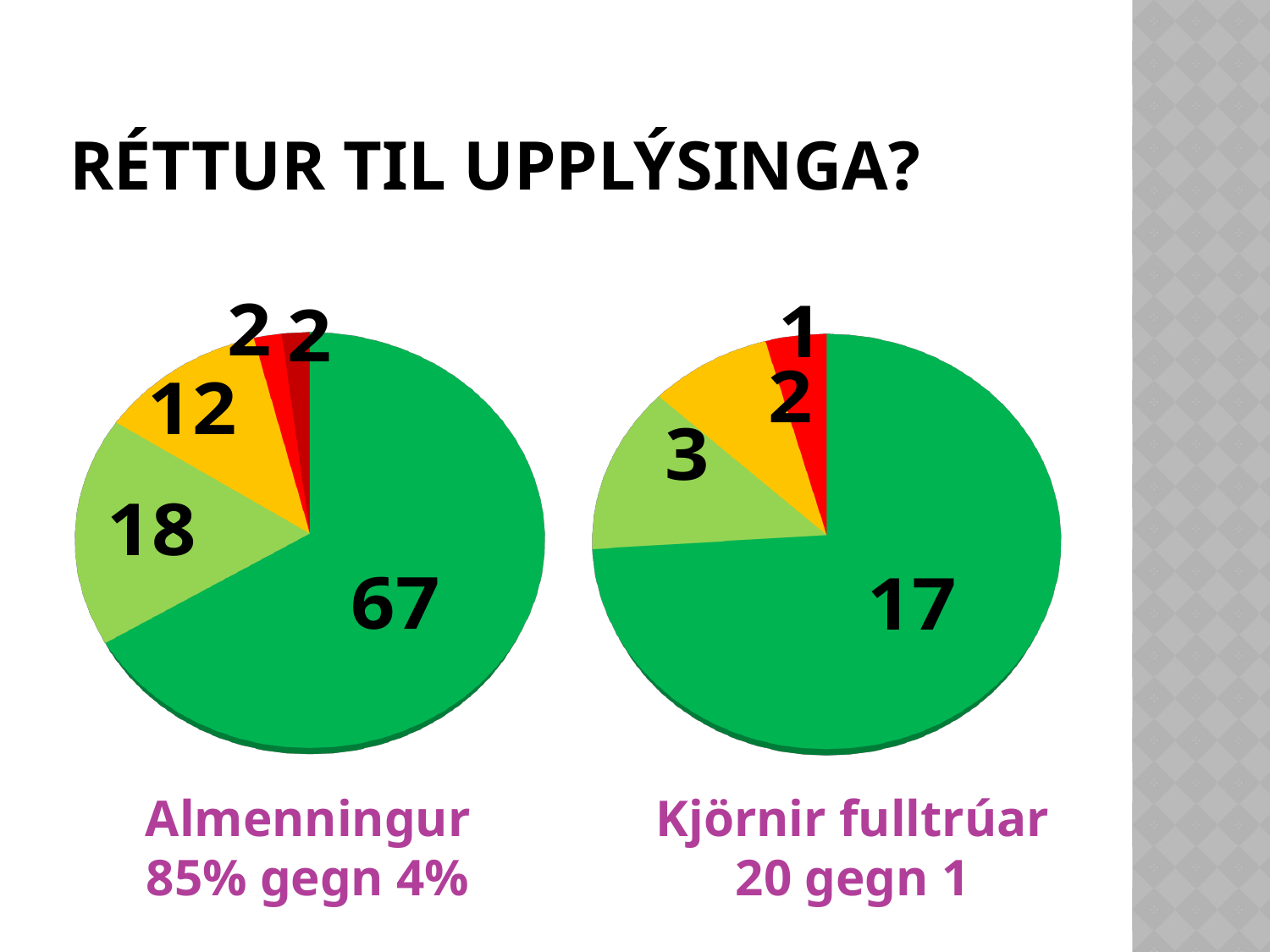
In the left chart (Almenningur), what is the value of the light green slice? 18 How many slices does the left chart (Almenningur) have? 5 In the left chart (Almenningur), what is the difference between the largest slice (67) and the second largest slice (18)? 49 In the right chart (Kjörnir fulltrúar), what is the value of the yellow slice? 2 What kind of chart is the left chart (Almenningur)? pie chart What caption is written below the left pie chart? Almenningur 85% gegn 4% In the left chart (Almenningur), what is the value of the largest slice? 67 In the left chart (Almenningur), which is larger: the light green slice or the yellow slice? the light green slice (18) What is the sum of all slice values in the right chart (Kjörnir fulltrúar)? 23 In the right chart (Kjörnir fulltrúar), what is the value of the smallest slice? 1 In the right chart (Kjörnir fulltrúar), what is the difference between the largest slice (17) and the light green slice (3)? 14 How many slices does the right chart (Kjörnir fulltrúar) have? 4